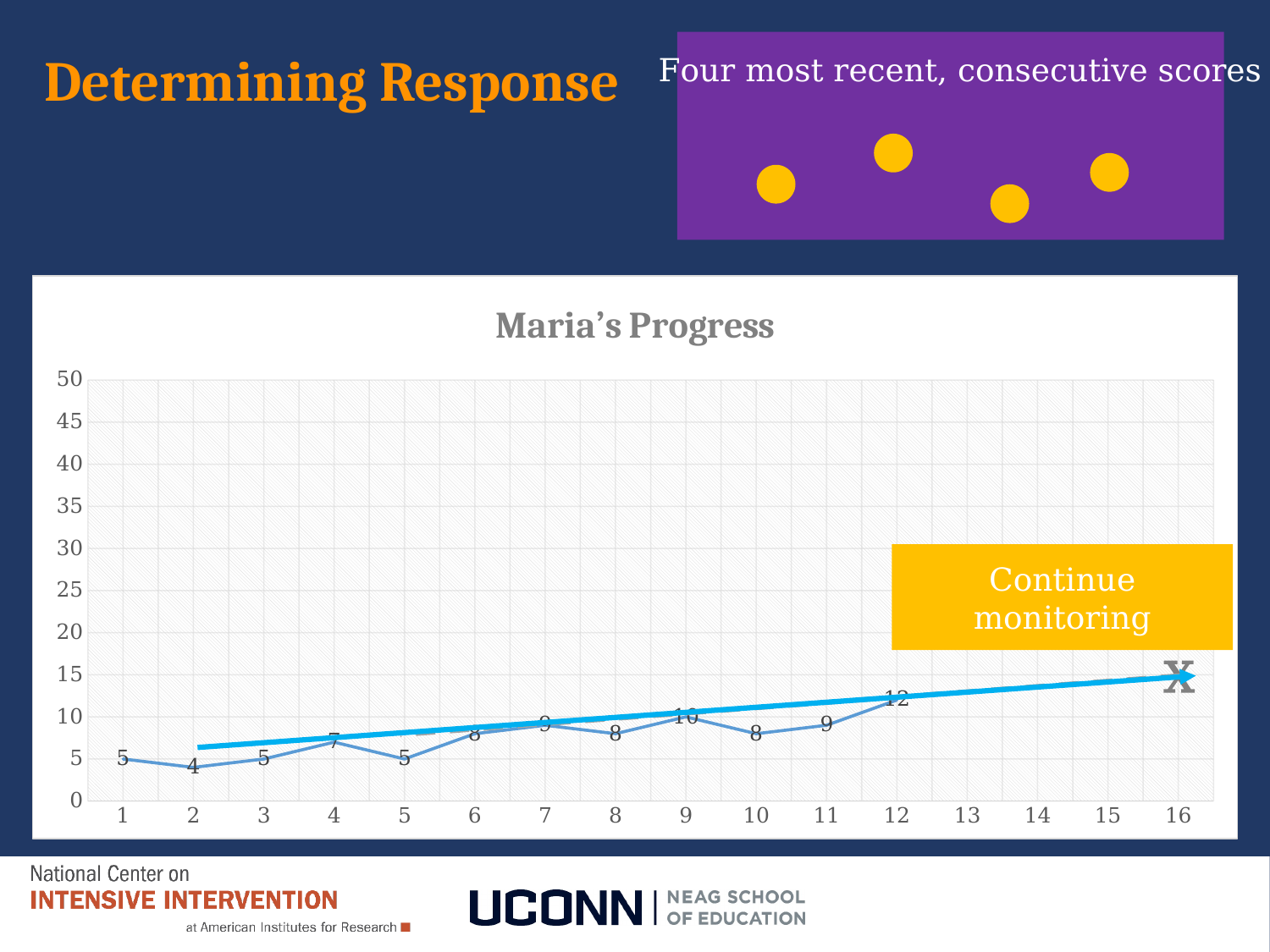
What is Maria's score at point 12? 12 What is the title of the chart? Maria's Progress At which point is Maria's score the lowest? 2 Is Maria's score at point 12 greater or less than 10? greater What is the highest value shown on the vertical axis? 50 What type of chart is shown on the slide? line chart At which point is Maria's labelled score the highest? 12 What is Maria's score at point 2? 4 What is the difference between Maria's score at point 12 and her score at point 1? 7 Which is larger, Maria's score at point 7 or at point 10? point 7 Overall, do Maria's scores rise or fall from point 1 to point 12? rise What is Maria's score at point 9? 10